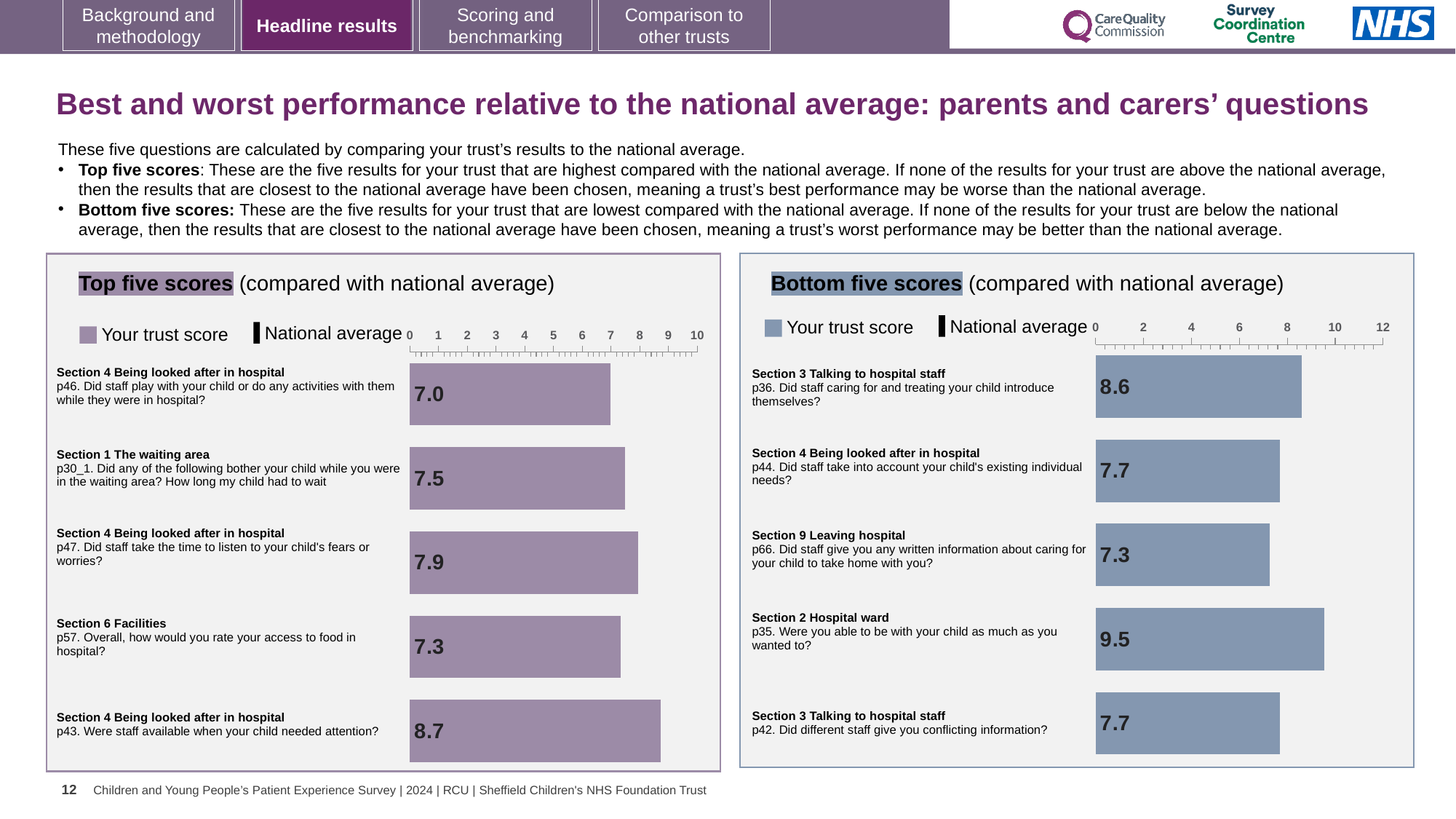
What kind of chart is the Bottom five scores chart? Bar chart In the Bottom five scores chart, which question has the lowest trust score? p66. Did staff give you any written information about caring for your child to take home with you? In the Top five scores chart, what is the trust score for p47 (Did staff take the time to listen to your child's fears or worries?)? 7.9 In the Bottom five scores chart, what is the difference between the trust scores for p35 and p66? 2.2 In the Top five scores chart, what is the trust score for p43 (Were staff available when your child needed attention?)? 8.7 In the Bottom five scores chart, which has the larger trust score: p36 (Did staff caring for and treating your child introduce themselves?) or p44 (Did staff take into account your child's existing individual needs?)? p36 In the Top five scores chart, which question has the highest trust score? p43. Were staff available when your child needed attention? In the Bottom five scores chart, what is the trust score for p35 (Were you able to be with your child as much as you wanted to?)? 9.5 How many questions are plotted in the Top five scores chart? 5 In the Top five scores chart, which question has the lowest trust score? p46. Did staff play with your child or do any activities with them while they were in hospital? In the Top five scores chart, what is the difference between the trust scores for p43 and p46? 1.7 In the Bottom five scores chart, which question has the highest trust score? p35. Were you able to be with your child as much as you wanted to?